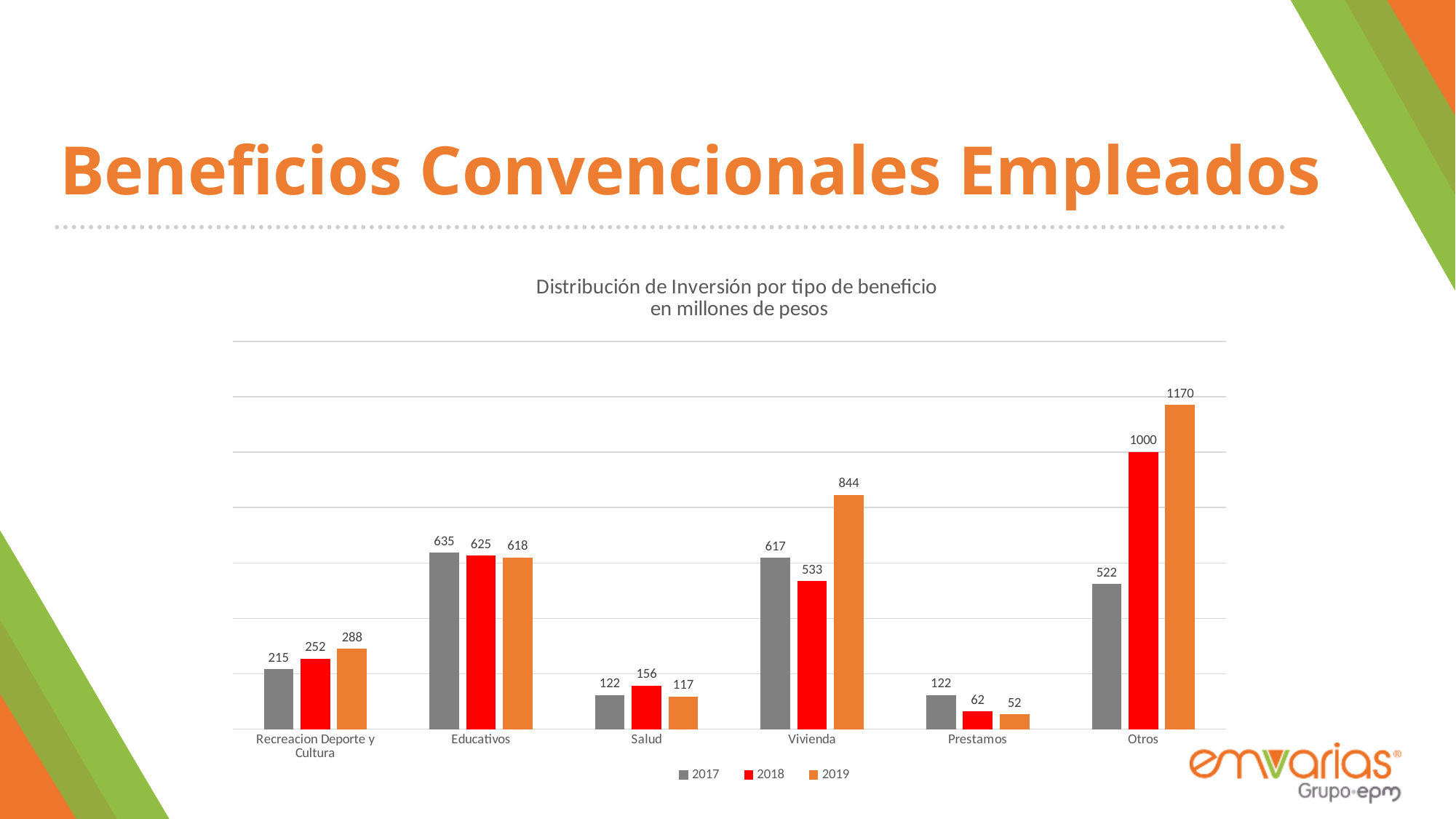
Which category has the lowest 2018 value? Prestamos What is the difference between the 2019 and 2018 values for Otros? 170 Which category has the highest 2019 value? Otros What kind of chart is shown on the slide? Bar chart What is the 2019 value for Vivienda? 844 Do the values for Recreacion Deporte y Cultura rise or fall from 2017 to 2019? Rise What is the title of the chart? Distribución de Inversión por tipo de beneficio en millones de pesos How many categories are shown on the x axis? 6 What is the 2017 value for Educativos? 635 What is the 2018 value for Prestamos? 62 Which is larger for Salud: the 2018 value or the 2019 value? 2018 How many series does the legend list? 3